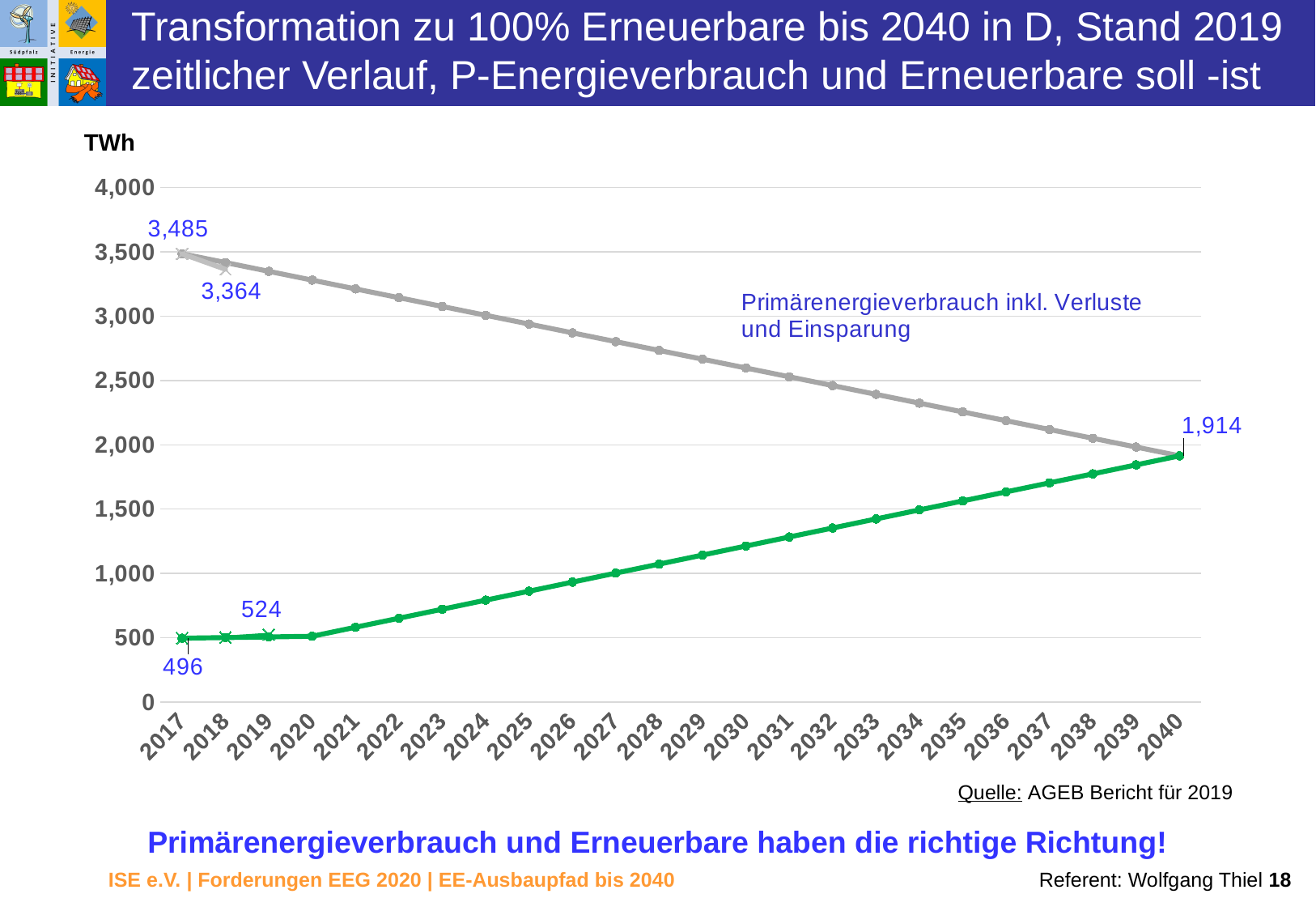
Does the green line (Erneuerbare) rise or fall from 2020 to 2040? rise What unit is shown at the top of the y axis? TWh What value do both lines reach in 2040? 1,914 Does the grey line (Primärenergieverbrauch) rise or fall from 2017 to 2040? fall What is the difference between the grey line value and the green line value in 2017? 2,989 What is the value of the green line (Erneuerbare) in 2017? 496 What kind of chart is shown on the slide? line chart What is the value of the grey line (Primärenergieverbrauch inkl. Verluste und Einsparung) in 2017? 3,485 In 2017, which line has the larger value, the grey line or the green line? the grey line By how much does the grey line (Primärenergieverbrauch) decrease from 2017 (3,485) to 2040 (1,914)? 1,571 Is the value of the grey line in 2035 greater or less than 2,500? less How many years are shown on the x axis? 24